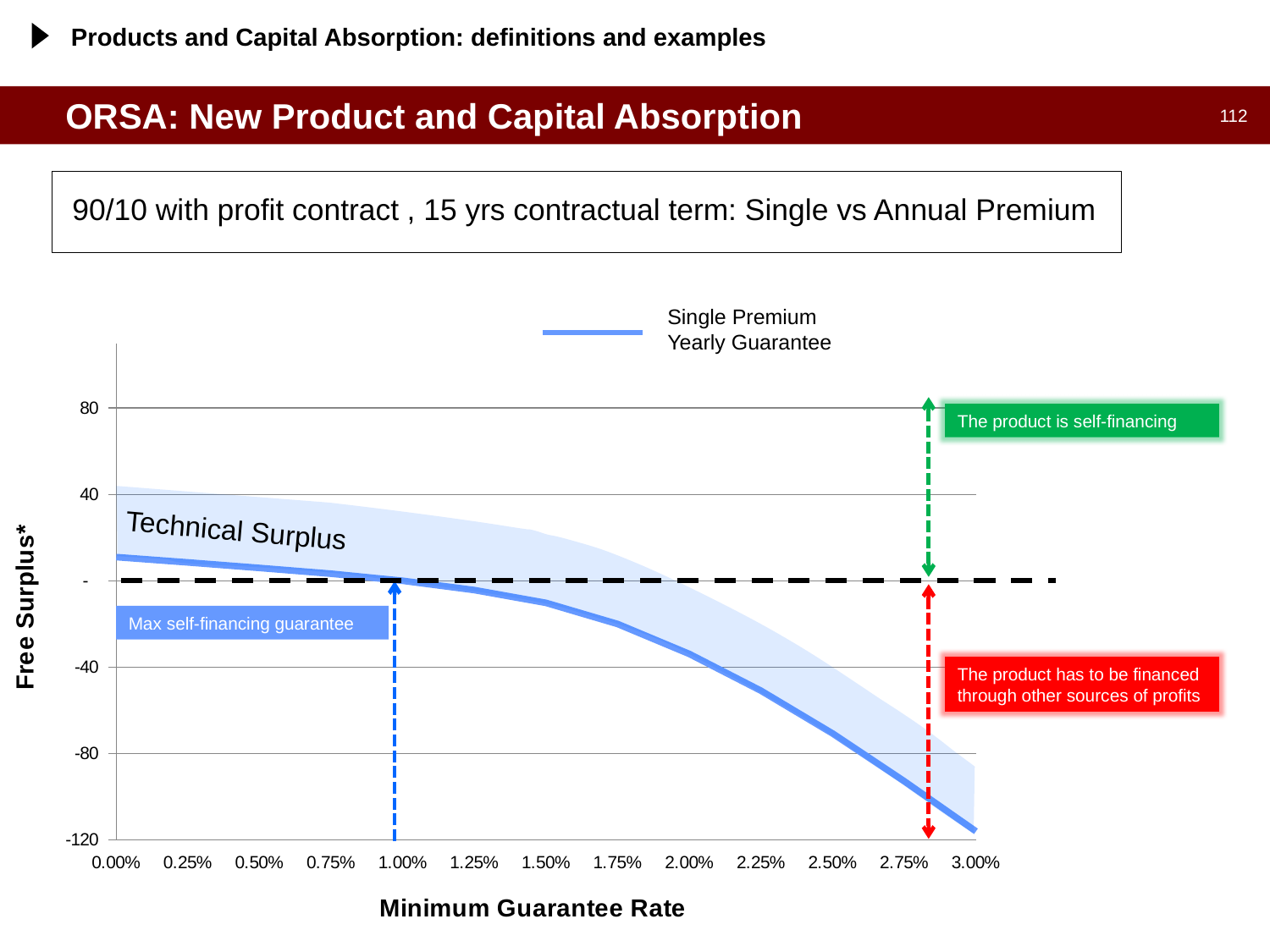
Which has the higher Free Surplus for the Single Premium Yearly Guarantee: a Minimum Guarantee Rate of 0.00% or 3.00%? 0.00% Is the Free Surplus for the Single Premium Yearly Guarantee at 3.00% greater or less than -80? less At which Minimum Guarantee Rate is the Single Premium Yearly Guarantee Free Surplus lowest? 3.00% What is the name of the series shown in the legend? Single Premium Yearly Guarantee What is the title of the x axis? Minimum Guarantee Rate Does the Single Premium Yearly Guarantee line rise or fall as the Minimum Guarantee Rate increases? fall At which Minimum Guarantee Rate does the Single Premium Yearly Guarantee line cross zero Free Surplus (the max self-financing guarantee)? 1.00% How many tick labels are shown on the x axis? 13 How many series does the chart legend list? 1 Is the Free Surplus for the Single Premium Yearly Guarantee at 2.00% greater or less than -40? greater Is the Free Surplus for the Single Premium Yearly Guarantee at 0.00% greater or less than 0? greater What kind of chart is shown on the slide? line chart